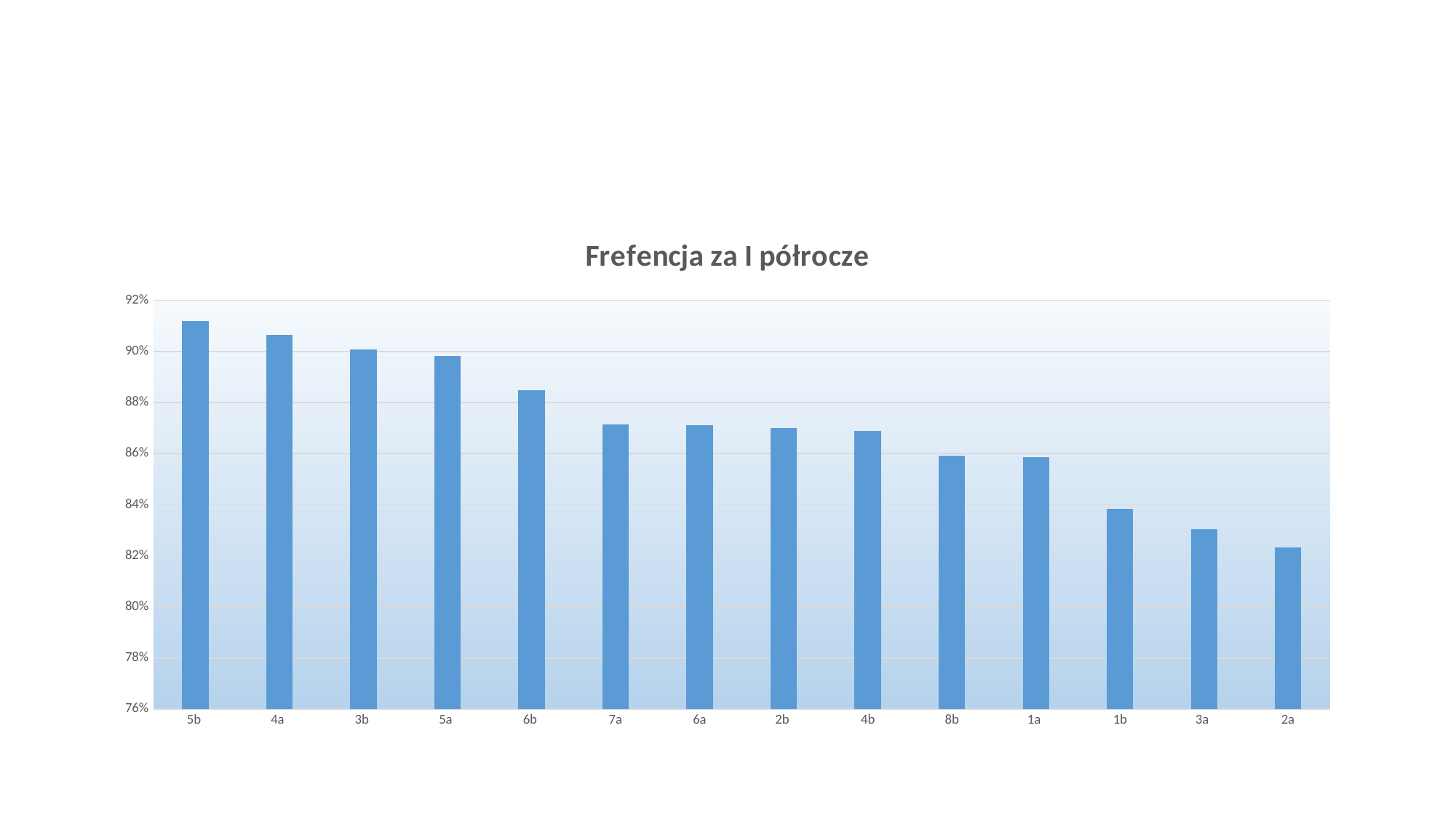
What kind of chart is shown on the slide? bar chart Is the value for 6b greater or less than 88%? greater Which is larger, the value for 6b or the value for 1b? 6b Which class has the lowest value? 2a Do the values rise or fall from left to right along the x axis? fall Which is larger, the value for 3a or the value for 4a? 4a Is the value for 1b greater or less than 86%? less How many categories (classes) are shown on the x axis? 14 Is the value for 5b greater or less than 90%? greater Which class has the highest value? 5b What is the title of the chart? Frefencja za I półrocze